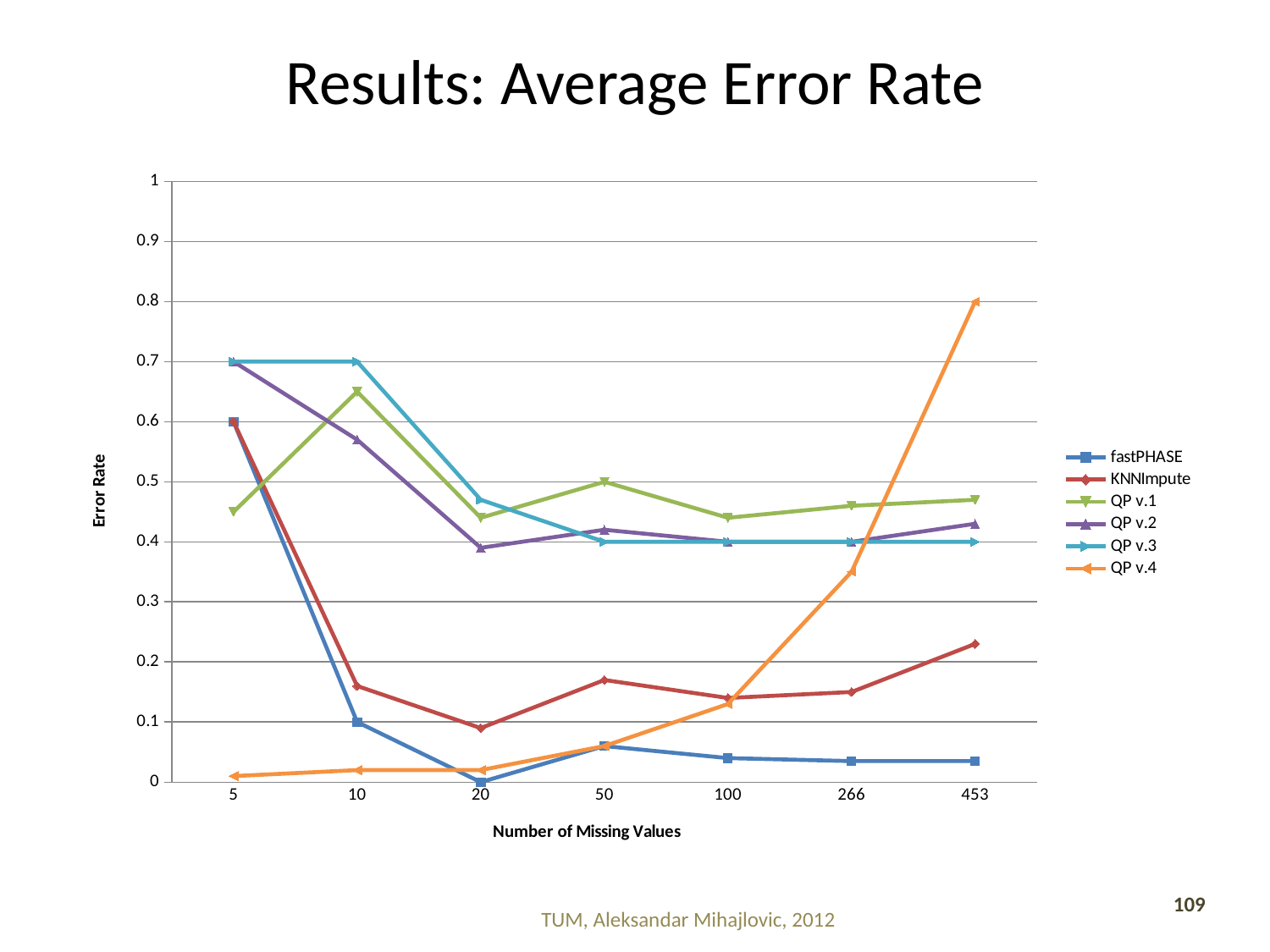
What kind of chart is shown on the slide? line chart Which series has the lowest error rate at 20 missing values? fastPHASE What is the label of the y axis? Error Rate What is the error rate for QP v.4 at 453 missing values? 0.8 Which series has the highest error rate at 453 missing values? QP v.4 How many points are on the x axis (Number of Missing Values)? 7 Is the error rate for QP v.1 at 10 missing values greater or less than 0.6? greater Does the error rate for QP v.4 rise or fall from 100 to 453 missing values? rise Is the error rate for QP v.4 at 266 missing values greater or less than 0.3? greater How many series does the legend list? 6 Which has the higher error rate at 5 missing values, QP v.1 or QP v.3? QP v.3 Is the error rate for KNNImpute at 10 missing values greater or less than 0.2? less